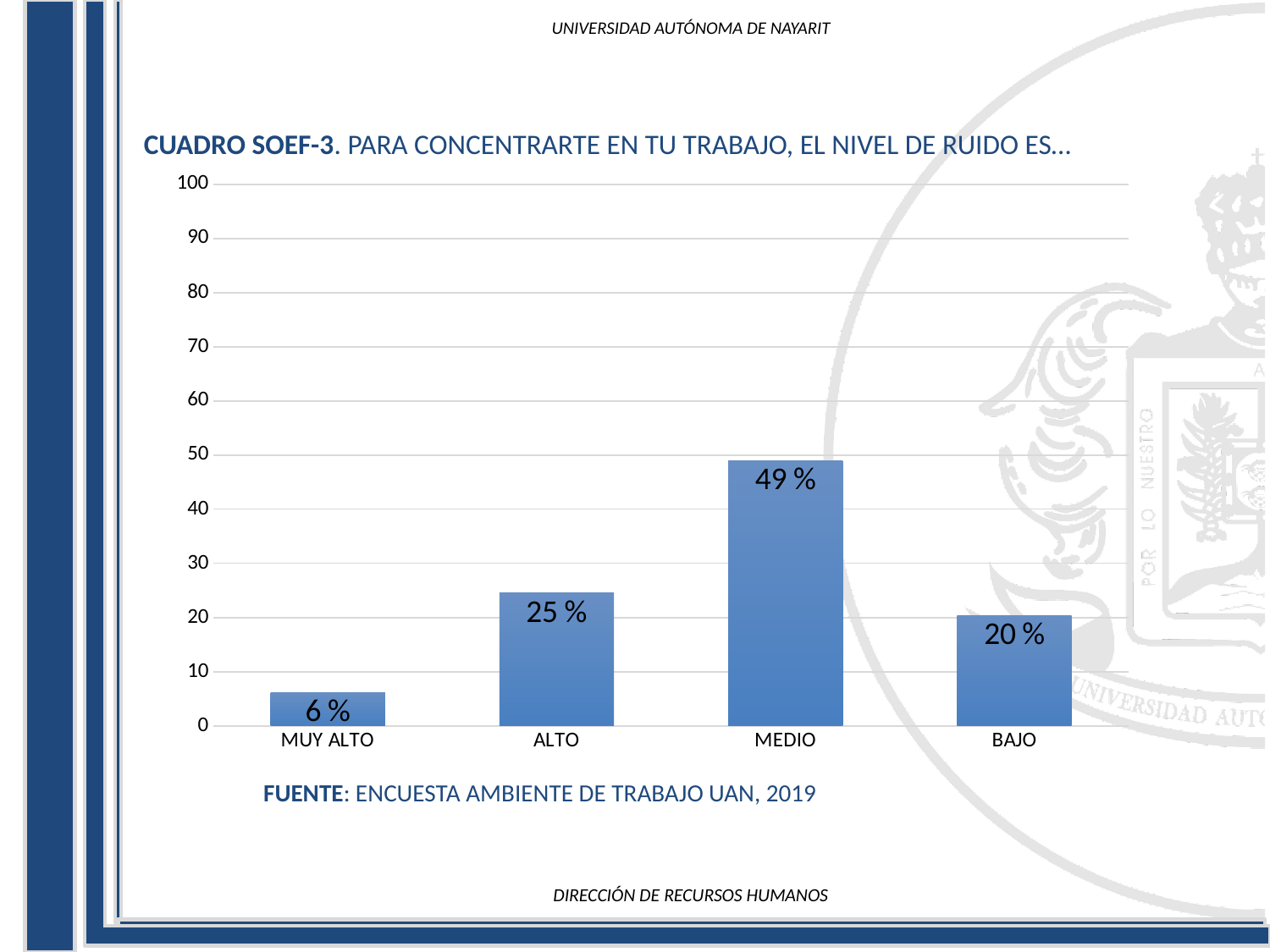
What kind of chart is shown on the slide? bar chart What source is cited below the chart? ENCUESTA AMBIENTE DE TRABAJO UAN, 2019 Which category has the highest value? MEDIO What is the difference between the values for MEDIO and ALTO? 24 % How many categories are shown on the x axis? 4 What is the value for MEDIO? 49 % What is the title of the chart? CUADRO SOEF-3. PARA CONCENTRARTE EN TU TRABAJO, EL NIVEL DE RUIDO ES… Is the value for MEDIO greater or less than 40? greater What is the value for MUY ALTO? 6 % What is the value for BAJO? 20 % Which category has the lowest value? MUY ALTO Which is larger, the value for ALTO or the value for BAJO? ALTO